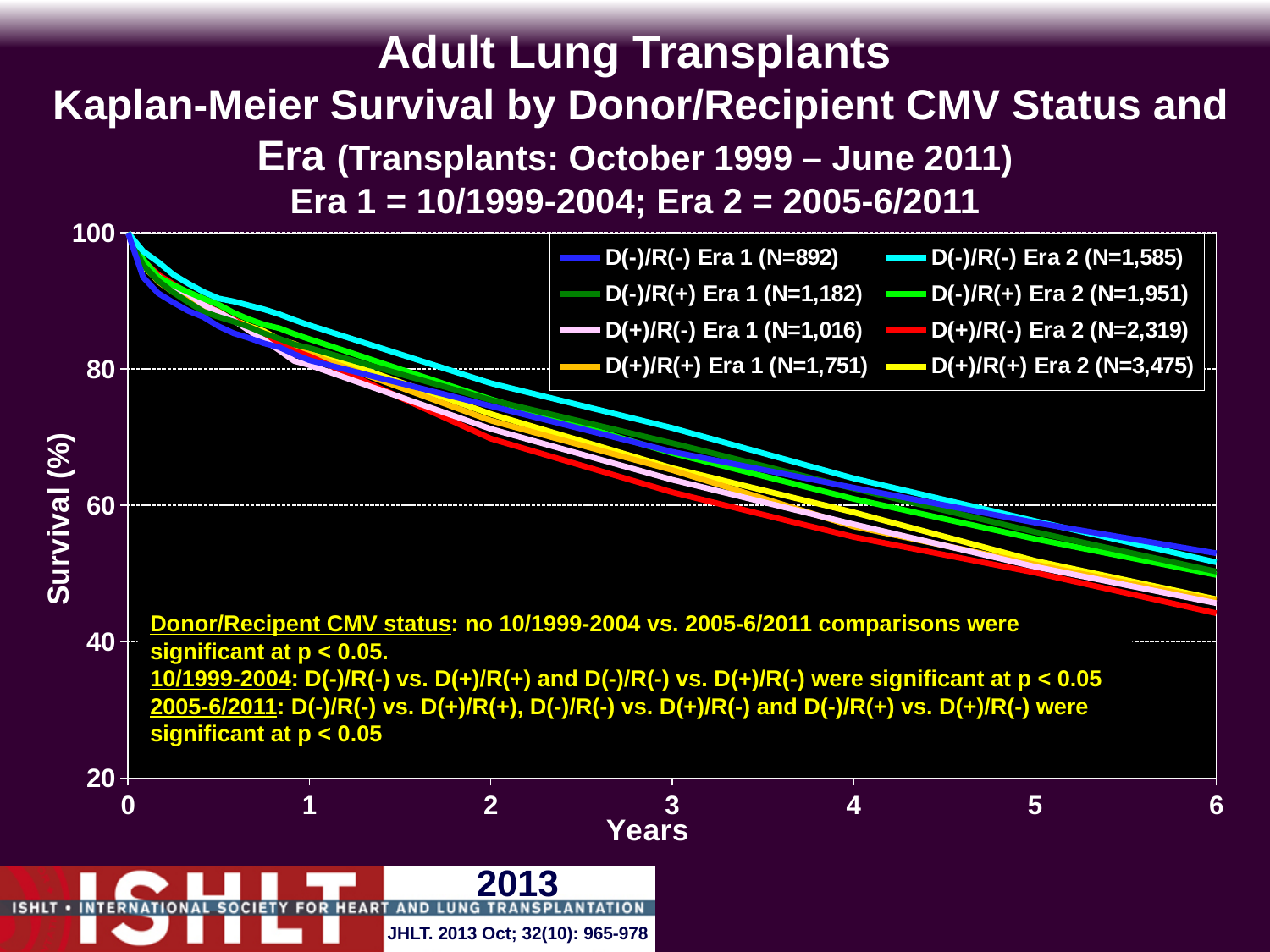
Which series has the lowest survival at 6 years? D(+)/R(-) Era 2 (N=2,319) Is the survival for D(+)/R(-) Era 2 at 6 years greater or less than 60? less Is the survival for D(-)/R(-) Era 2 at 1 year greater or less than 80? greater How many series does the legend list? 8 Is the survival for D(+)/R(-) Era 2 at 4 years greater or less than 60? less What kind of chart is shown on the slide? line chart Do the survival curves rise or fall as years increase? fall What is the label of the y-axis? Survival (%) According to the legend, what is the N for the D(+)/R(+) Era 2 series? 3,475 At 6 years, which has higher survival: D(-)/R(-) Era 2 or D(+)/R(-) Era 2? D(-)/R(-) Era 2